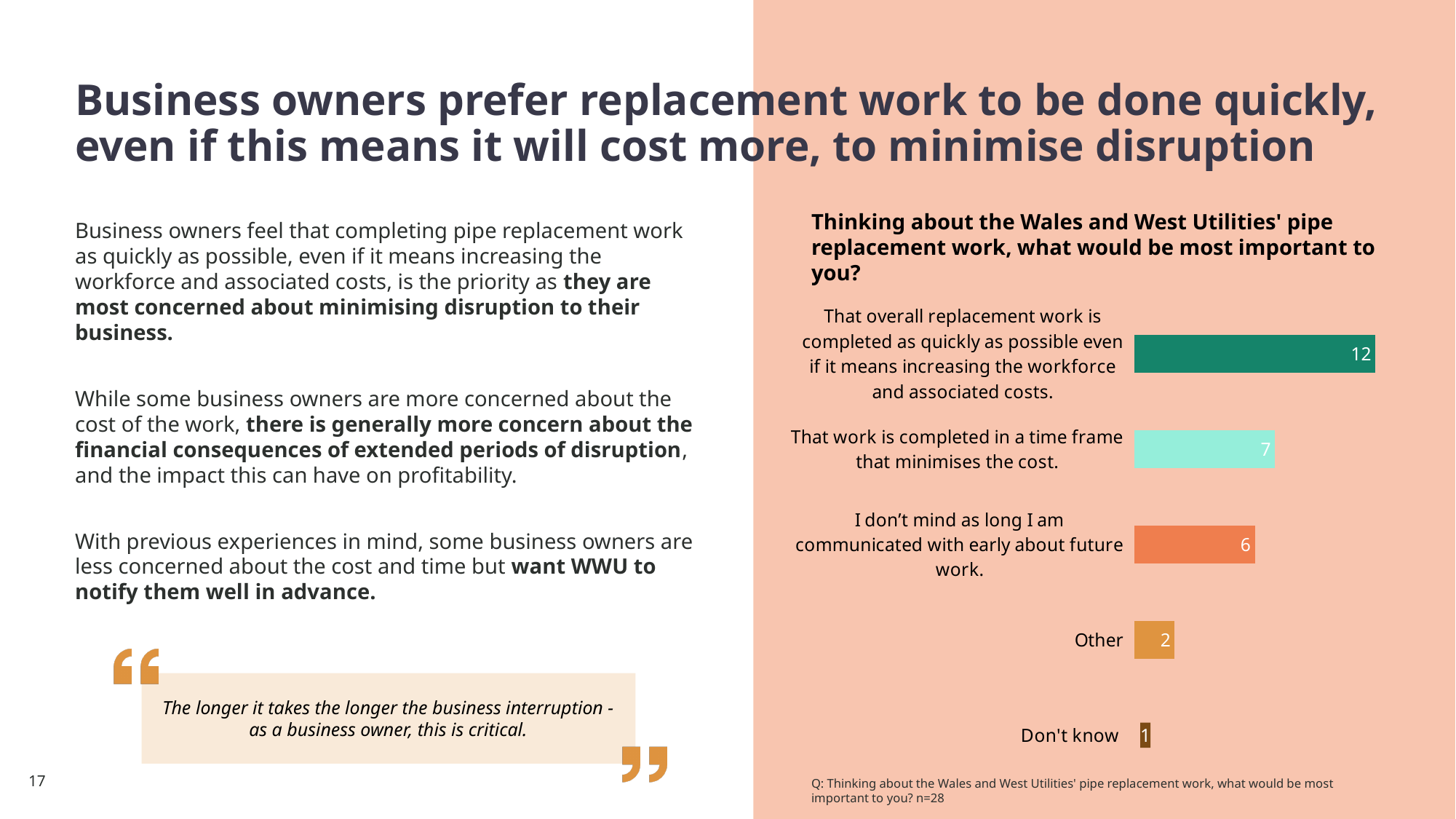
What is the value for 'Other'? 2 What is the value for 'That work is completed in a time frame that minimises the cost'? 7 How many respondents said that overall replacement work should be completed as quickly as possible even if it means increasing the workforce and associated costs? 12 What kind of chart is shown on the slide? Bar chart How many response categories are shown in the chart? 5 Which response option has the highest value? That overall replacement work is completed as quickly as possible even if it means increasing the workforce and associated costs. What is the sample size (n) stated in the chart footnote? n=28 What is the value for 'I don't mind as long I am communicated with early about future work'? 6 Which response option has the lowest value? Don't know What is the difference between the value for completing work as quickly as possible and the value for completing work in a time frame that minimises the cost? 5 What is the value for 'Don't know'? 1 Which is larger: the value for 'That work is completed in a time frame that minimises the cost' or the value for 'I don't mind as long I am communicated with early about future work'? That work is completed in a time frame that minimises the cost.